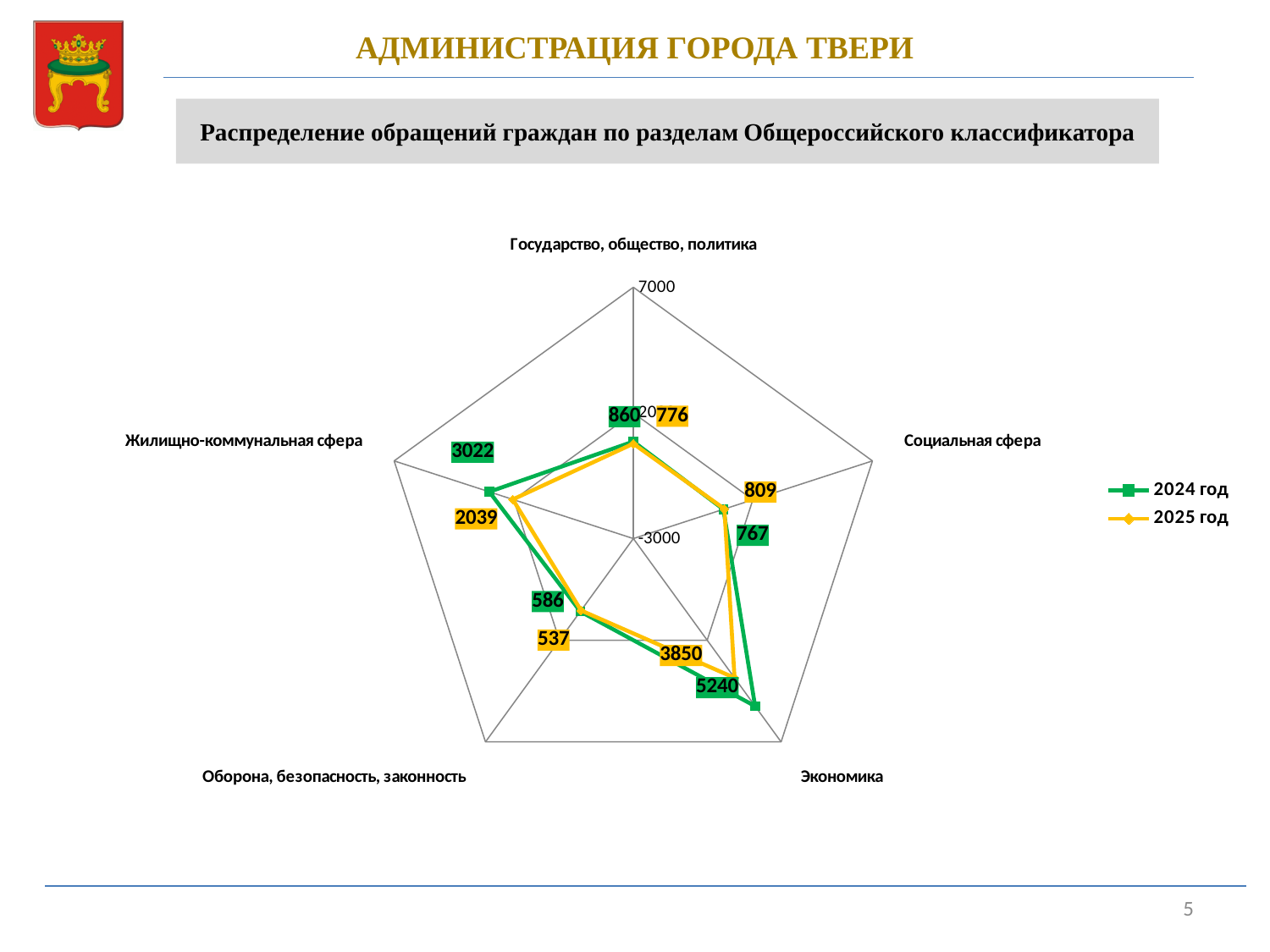
For Социальная сфера, which series has the larger value, 2024 год or 2025 год? 2025 год How many categories (axes) does the radar chart have? 5 What kind of chart is shown on the slide? radar chart What is the value for Экономика in the 2024 год series? 5240 Which colour represents the 2025 год series? yellow Which category has the highest value in the 2024 год series? Экономика What is the value for Социальная сфера in the 2024 год series? 767 What is the value for Жилищно-коммунальная сфера in the 2025 год series? 2039 What is the value for Экономика in the 2025 год series? 3850 Which category has the lowest value in the 2025 год series? Оборона, безопасность, законность What is the difference between the 2024 год and 2025 год values for Жилищно-коммунальная сфера? 983 How many series does the legend list? 2